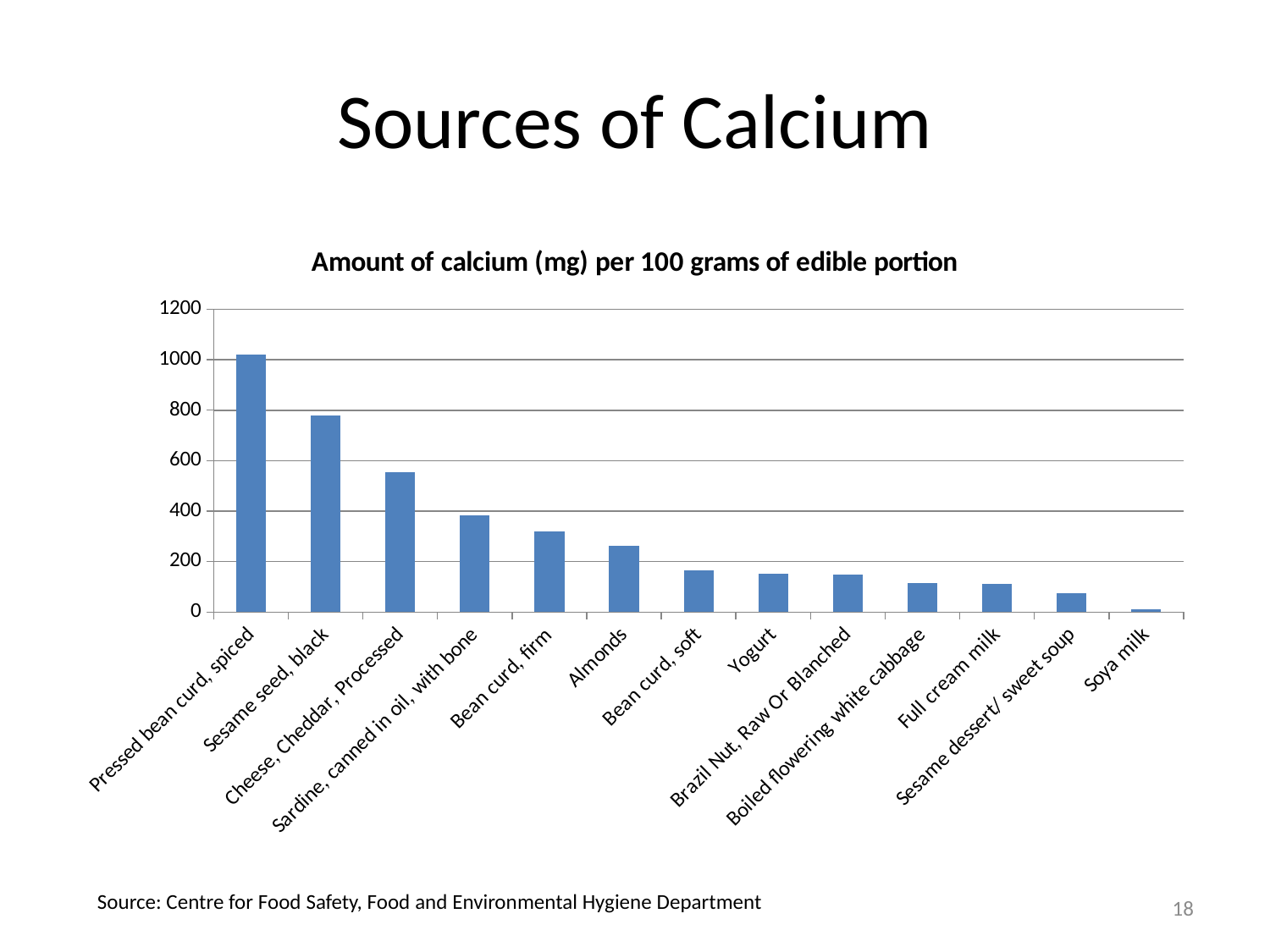
Is the value for Sesame seed, black greater or less than 600? greater Which has a higher calcium value, Almonds or Bean curd, firm? Bean curd, firm Which food has the lowest amount of calcium in the chart? Soya milk Which food has the highest amount of calcium in the chart? Pressed bean curd, spiced Which has a higher calcium value, Full cream milk or Sesame dessert/ sweet soup? Full cream milk What kind of chart is shown on the slide? bar chart What is the title of the chart? Amount of calcium (mg) per 100 grams of edible portion Do the values rise or fall moving from left to right along the x axis? fall Is the value for Pressed bean curd, spiced greater or less than 800? greater How many food categories are plotted in the chart? 13 Is the value for Yogurt greater or less than 200? less